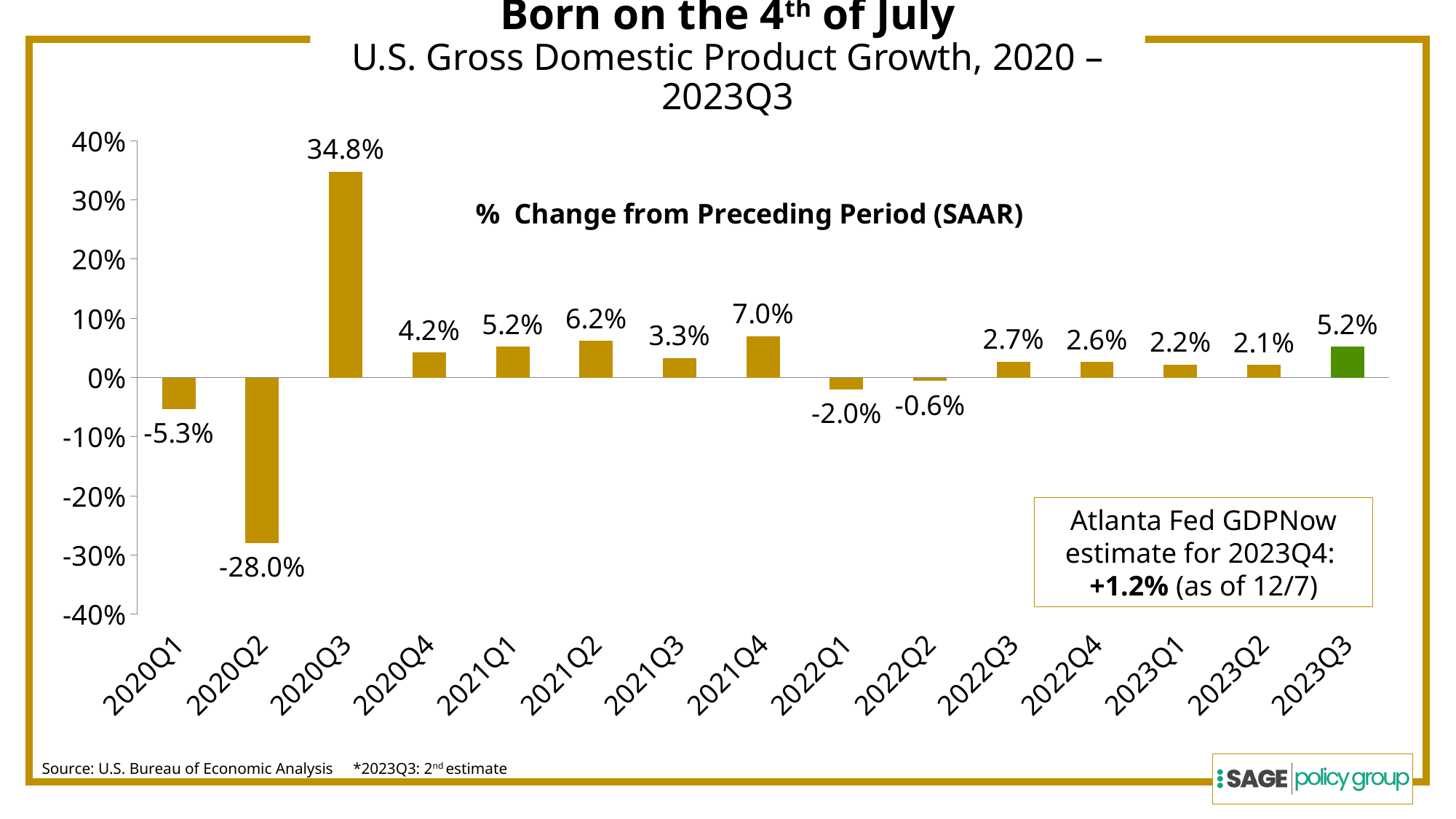
What is the difference between the GDP growth values for 2021Q4 and 2021Q3? 3.7% What is the GDP growth value for 2020Q2? -28.0% How many quarters are shown on the chart? 15 Do the GDP growth values rise or fall from 2022Q3 to 2023Q2? Fall Which quarter has the highest GDP growth? 2020Q3 Which quarter has the lowest GDP growth? 2020Q2 What kind of chart is shown on the slide? Bar chart What is the GDP growth value for 2020Q3? 34.8% What is the GDP growth value for 2023Q3? 5.2% What is the GDP growth value for 2022Q2? -0.6% Which is larger, the GDP growth for 2021Q2 or for 2022Q3? 2021Q2 Which bar is shown in a different colour (green) from the others? 2023Q3